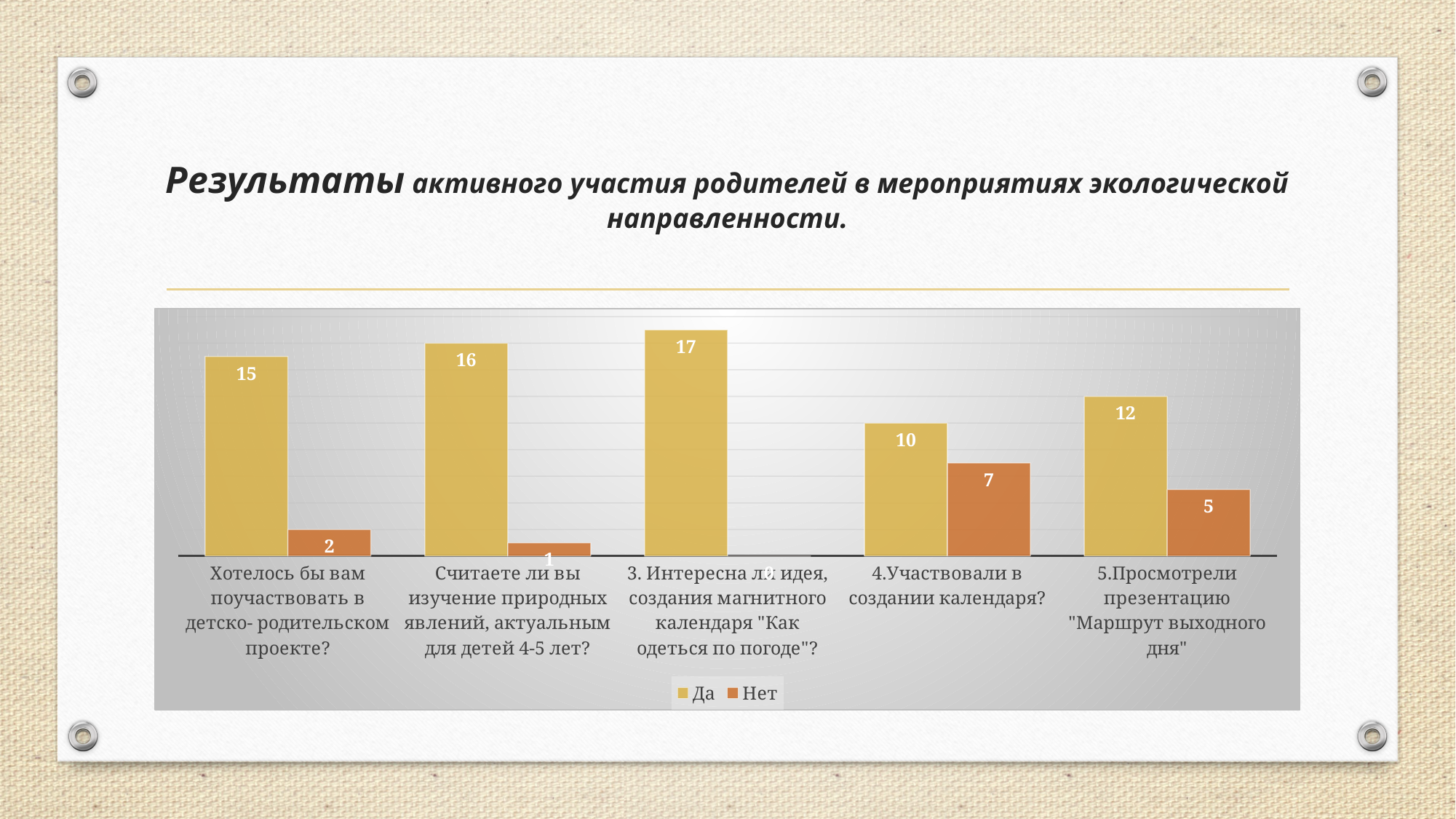
What kind of chart is shown on the slide? Bar chart How many series does the chart legend list? 2 What is the value of "Да" for the category "Хотелось бы вам поучаствовать в детско- родительском проекте?"? 15 Which category has the highest "Нет" value? 4.Участвовали в создании календаря? Which category has the lowest "Да" value? 4.Участвовали в создании календаря? Which category has the highest "Да" value? 3. Интересна ли идея, создания магнитного календаря "Как одеться по погоде"? Which is larger: the "Да" value for "Считаете ли вы изучение природных явлений, актуальным для детей 4-5 лет?" or the "Да" value for "5.Просмотрели презентацию "Маршрут выходного дня""? Считаете ли вы изучение природных явлений, актуальным для детей 4-5 лет? How many categories are shown on the x axis of the chart? 5 What is the value of "Да" for the category "4.Участвовали в создании календаря?"? 10 What is the value of "Нет" for the category "5.Просмотрели презентацию "Маршрут выходного дня""? 5 What is the difference between the "Да" and "Нет" values for "4.Участвовали в создании календаря?"? 3 What are the two series named in the chart legend? Да and Нет